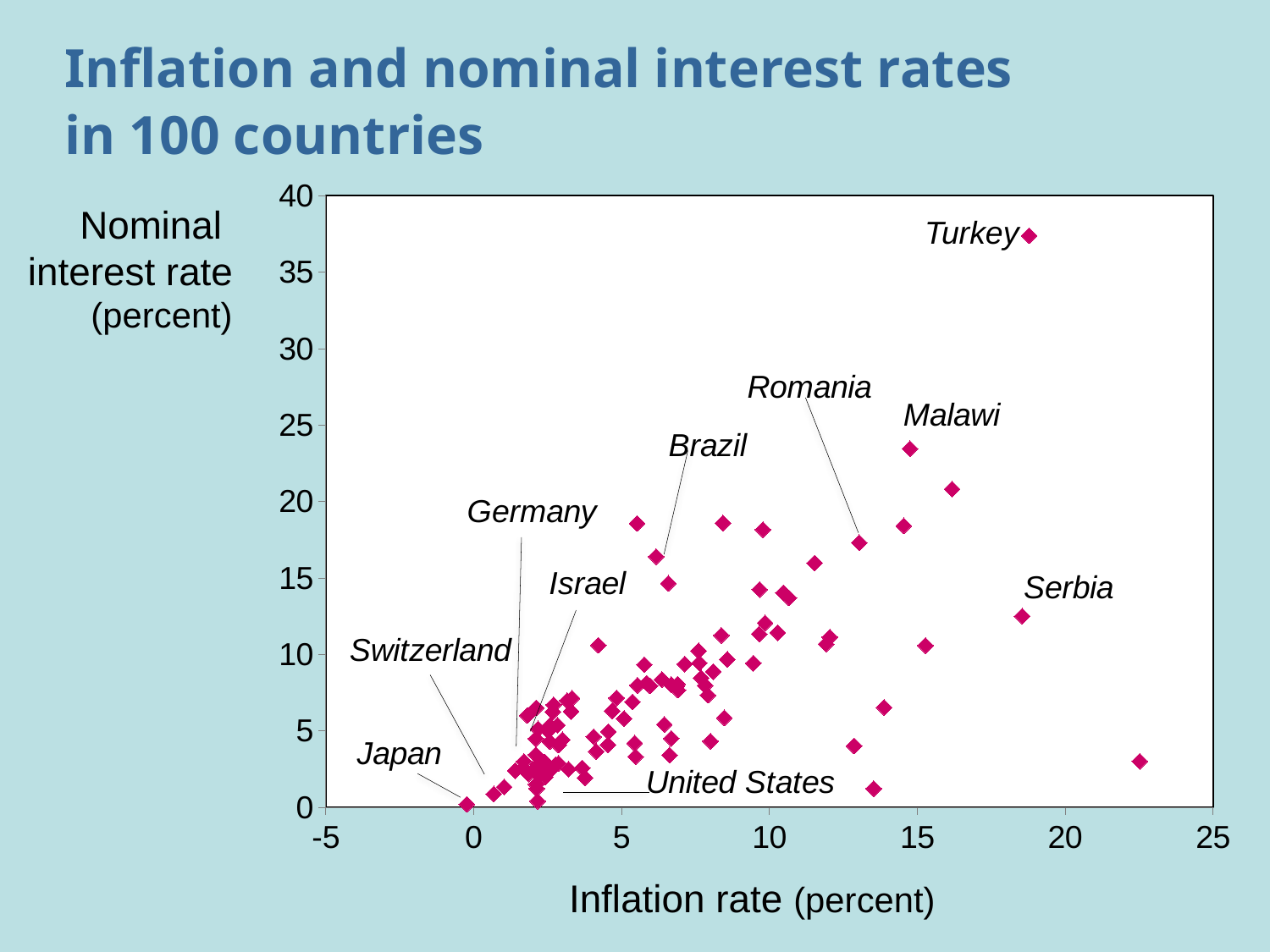
Is the inflation rate for Serbia greater or less than 15? greater As the inflation rate increases along the x axis, do nominal interest rates generally rise or fall? Rise What kind of chart is shown on the slide? Scatter plot Is the nominal interest rate for Malawi greater or less than 20? greater What is the title of the chart? Inflation and nominal interest rates in 100 countries What variable is plotted on the horizontal axis? Inflation rate (percent) Is the inflation rate for Japan greater or less than 5? less Which labeled country has the lowest nominal interest rate? Japan According to the chart title, how many countries are plotted? 100 Which labeled country has the highest nominal interest rate? Turkey Which has the higher nominal interest rate, Malawi or Serbia? Malawi